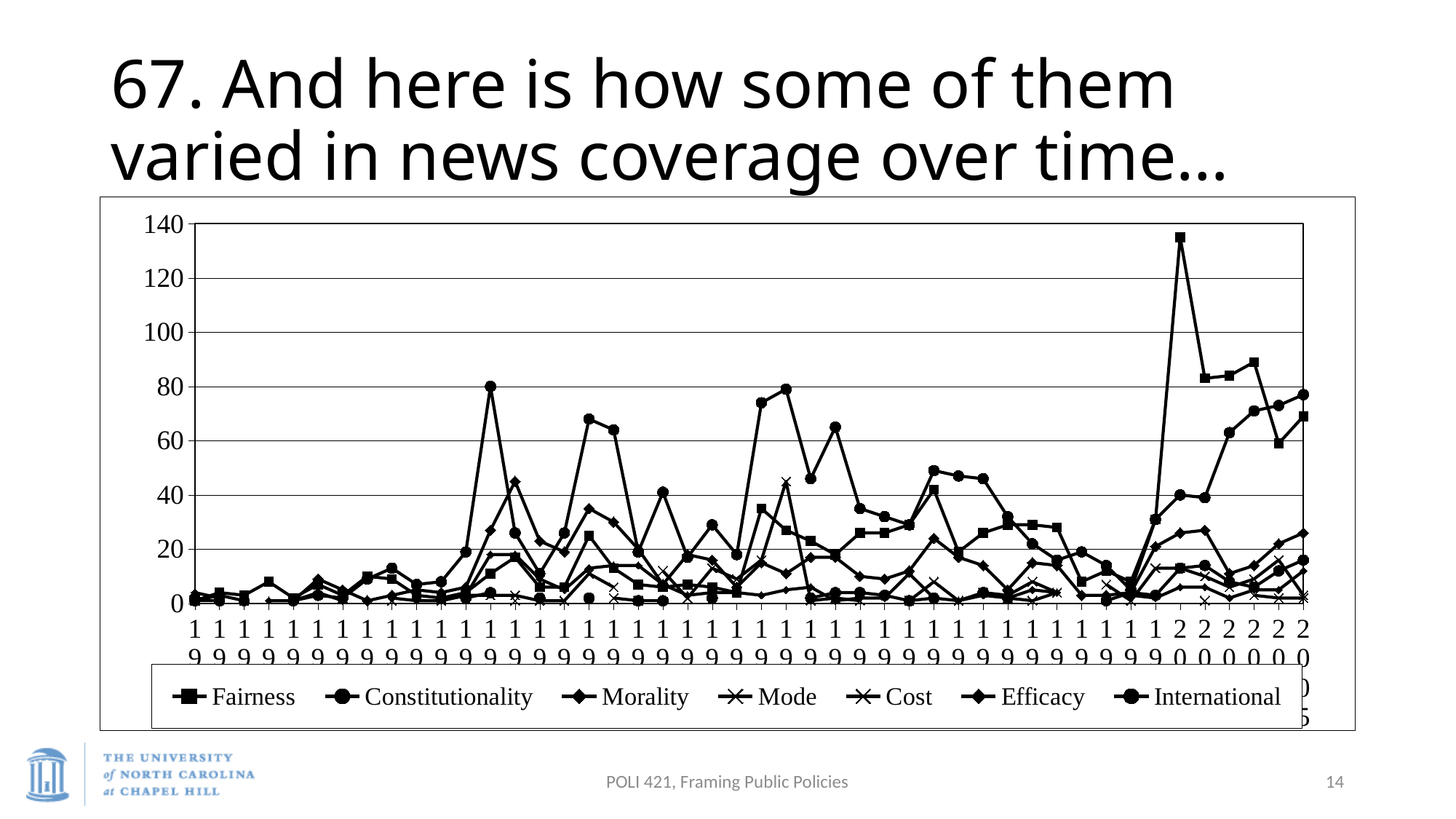
Is the highest value reached by the Morality series greater or less than 60? less Is the highest value reached by the Mode series greater or less than 40? greater Is the highest value reached by the Fairness series greater or less than 120? greater How many series does the legend list? 7 What kind of chart is shown on the slide? line chart Which series reaches the highest value anywhere on the chart? Fairness Which series is listed first in the legend? Fairness What is the highest value shown on the vertical axis? 140